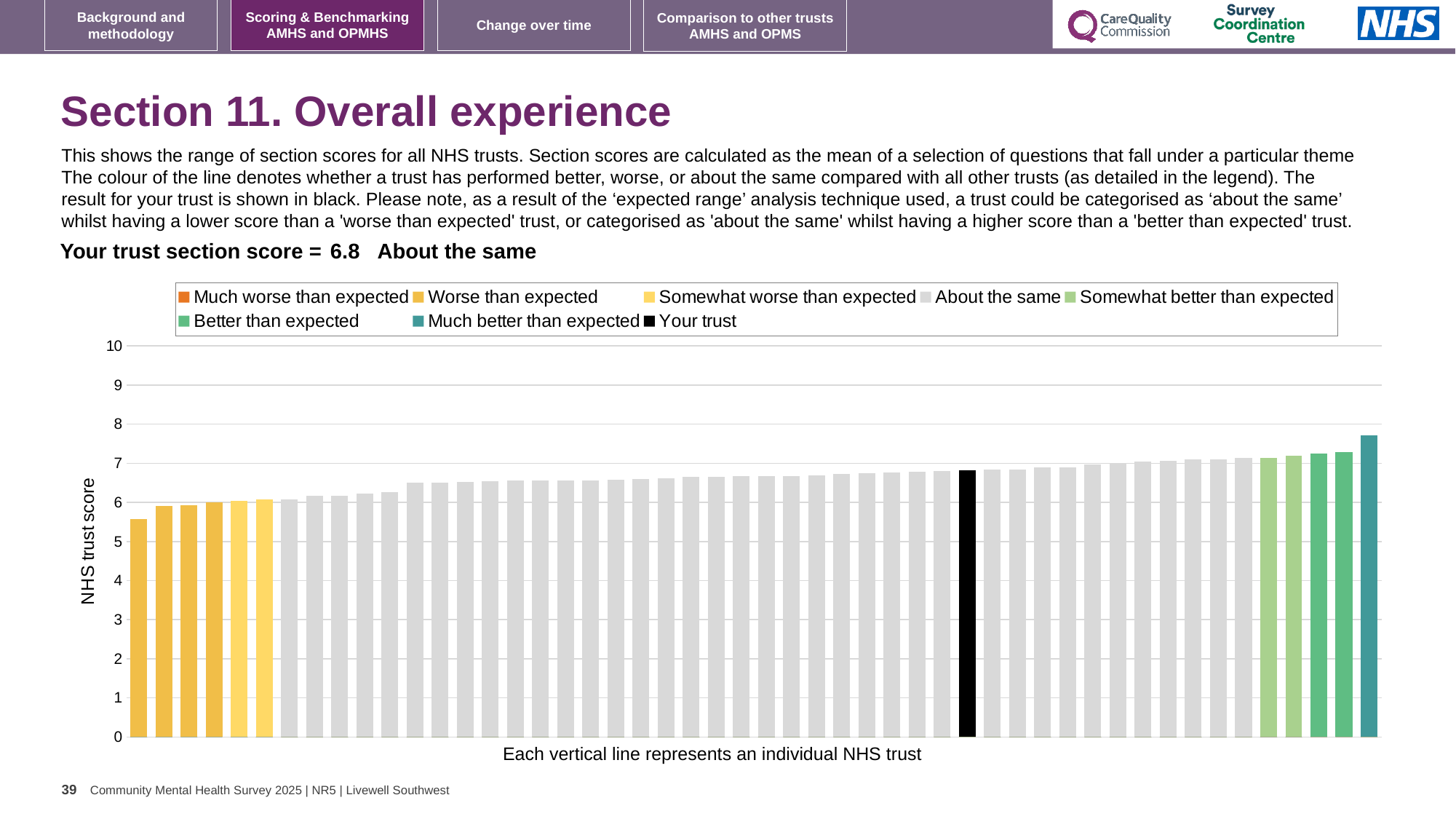
Which category does your trust fall into for this section? About the same What is the highest value shown on the y axis? 10 What kind of chart is shown on the slide? Bar chart Do the bar values rise or fall from left to right along the x axis? Rise Is the value of the shortest bar greater or less than 6? less What is the section score for your trust shown on the slide? 6.8 How many entries does the chart legend list? 8 What is the label on the x axis of the chart? Each vertical line represents an individual NHS trust Is the value of the tallest bar greater or less than 7? greater Is the value of the black bar (your trust) greater or less than 7? less Which legend entry is shown in black? Your trust What is the label on the y axis of the chart? NHS trust score